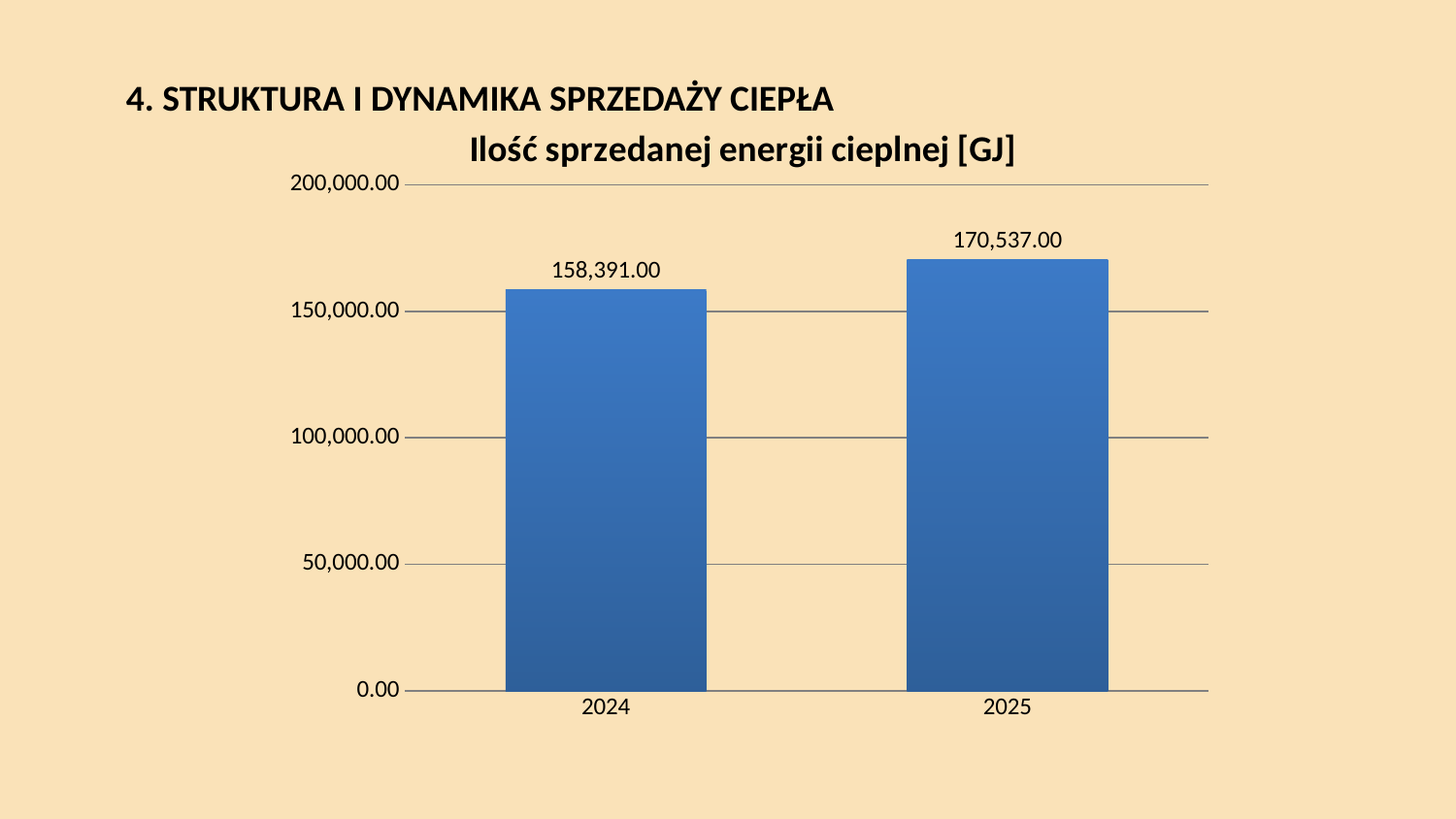
Is the value for 2024 greater or less than 150,000.00? greater Which year has the lowest value? 2024 What is the title of the chart? Ilość sprzedanej energii cieplnej [GJ] Which is larger, the value for 2024 or the value for 2025? 2025 Do the values rise or fall from 2024 to 2025? rise Is the value for 2025 greater or less than 200,000.00? less What is the value for 2024? 158,391.00 How many categories are shown on the x axis? 2 What is the difference between the values for 2025 and 2024? 12,146.00 What kind of chart is shown on the slide? bar chart What is the value for 2025? 170,537.00 Which year has the highest value? 2025